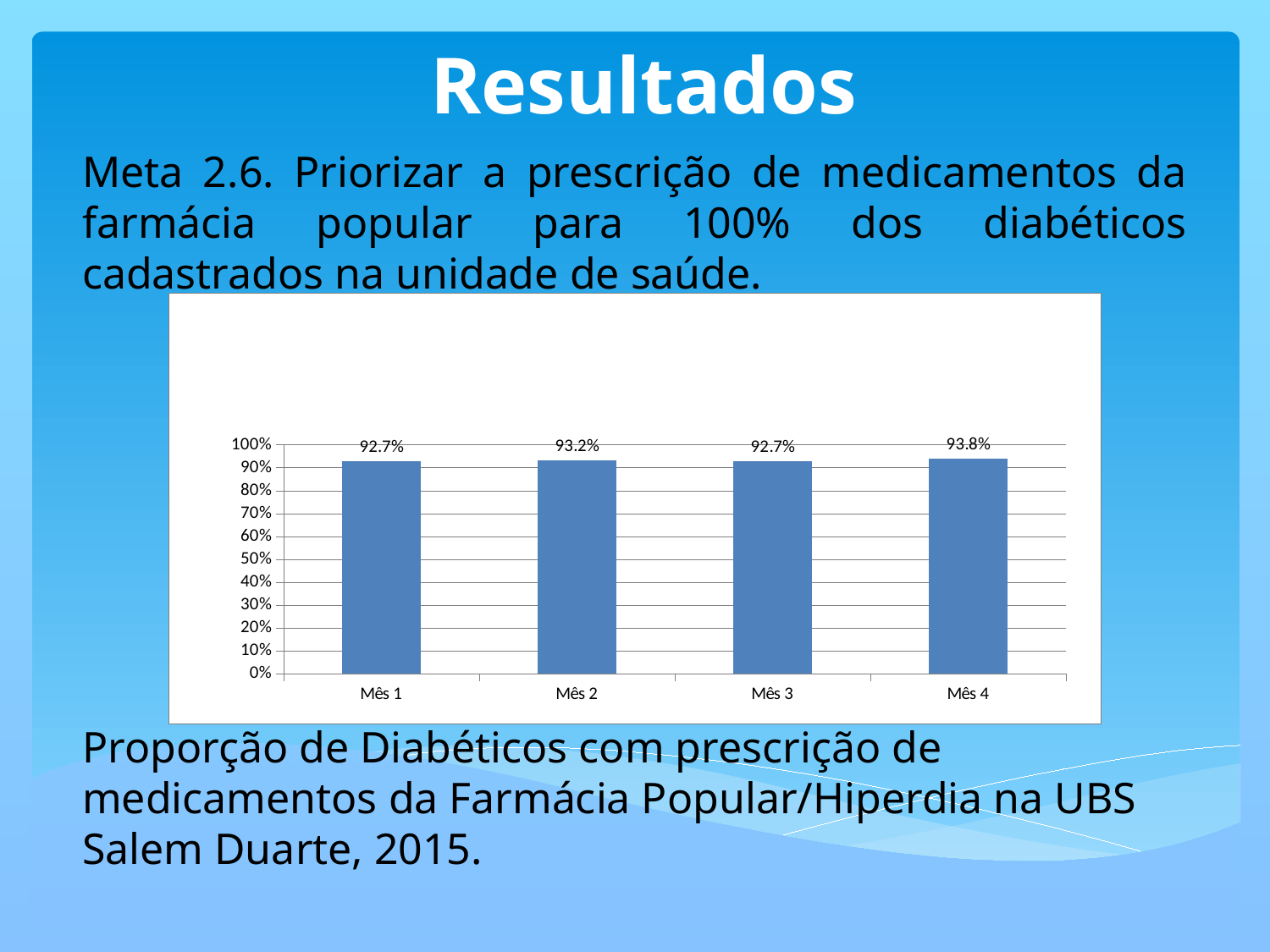
Is the value for Mês 3 greater or less than 90%? greater What is the highest tick shown on the y axis? 100% What is the difference between the values for Mês 2 and Mês 1? 0.5 percentage points What is the value for Mês 2? 93.2% Which is larger, the value for Mês 2 or the value for Mês 3? Mês 2 How many months are shown on the x axis? 4 What is the value for Mês 4? 93.8% What is the difference between the values for Mês 4 and Mês 2? 0.6 percentage points Do the values for Mês 1 and Mês 3 have the same value? Yes, both are 92.7% Which month has the highest value? Mês 4 What is the value for Mês 1? 92.7% What kind of chart is shown on the slide? Bar chart